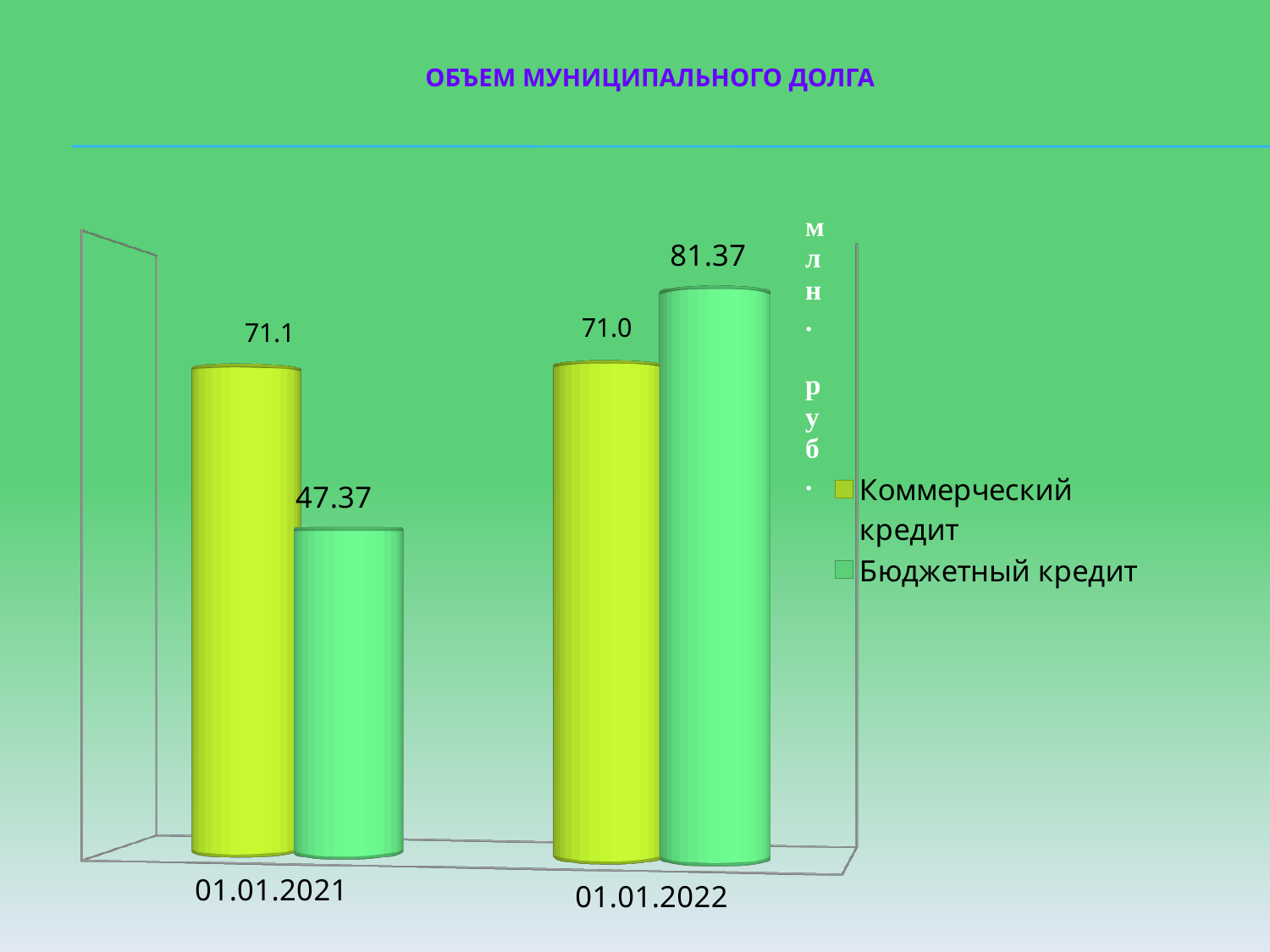
Which bar has the highest value on the chart? Бюджетный кредит on 01.01.2022 What is the difference between Бюджетный кредит on 01.01.2022 and on 01.01.2021? 34 How many dates are shown on the x axis? 2 What is the title of the chart? ОБЪЕМ МУНИЦИПАЛЬНОГО ДОЛГА What is the value of Бюджетный кредит on 01.01.2021? 47.37 On 01.01.2021, which is larger: Коммерческий кредит or Бюджетный кредит? Коммерческий кредит What is the value of Коммерческий кредит on 01.01.2021? 71.1 What is the value of Коммерческий кредит on 01.01.2022? 71.0 What kind of chart is shown on the slide? Bar chart What is the value of Бюджетный кредит on 01.01.2022? 81.37 Which bar has the lowest value on the chart? Бюджетный кредит on 01.01.2021 How many series does the legend list? 2